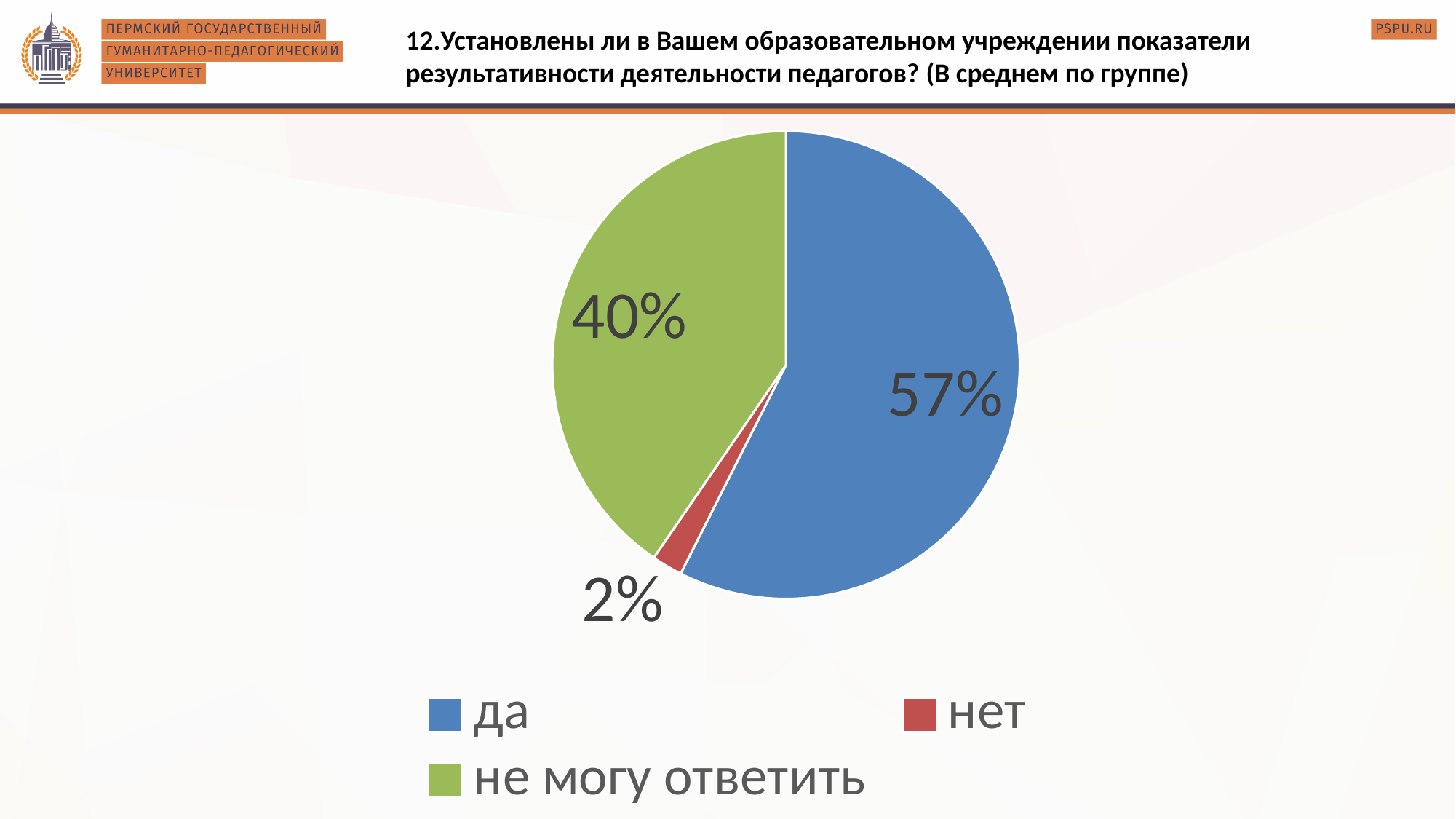
What share of the pie does "нет" take? 2% What is the difference in percentage points between "не могу ответить" and "нет"? 38 Which category has the largest slice of the pie? да What share of the pie does "не могу ответить" take? 40% Which category is shown in red in the legend? нет What is the difference in percentage points between "да" and "не могу ответить"? 17 Which category has the smallest slice of the pie? нет How many categories does the pie chart show? 3 What kind of chart is shown on the slide? pie chart Which is larger, the share for "да" or the share for "не могу ответить"? да What share of the pie does "да" take? 57% What colour is the slice for "не могу ответить"? green